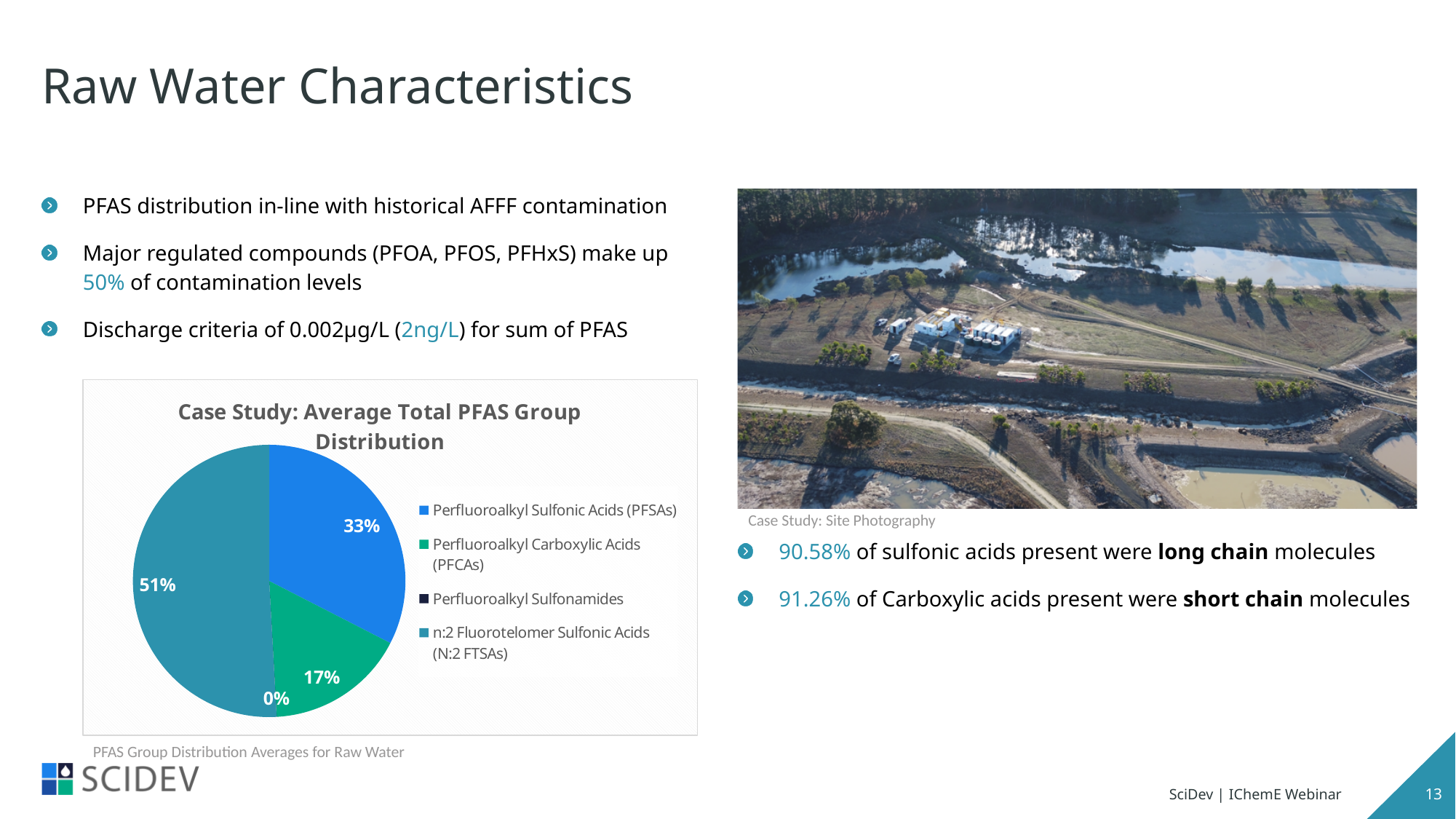
What kind of chart is shown on the slide? Pie chart What share of the pie is n:2 Fluorotelomer Sulfonic Acids (N:2 FTSAs)? 51% Which is larger, the share for PFSAs or the share for PFCAs? Perfluoroalkyl Sulfonic Acids (PFSAs) Which PFAS group has the largest share of the pie? n:2 Fluorotelomer Sulfonic Acids (N:2 FTSAs) What is the difference in percentage points between the PFSAs share and the PFCAs share? 16 How many PFAS groups are listed in the chart legend? 4 Which PFAS group has the smallest share of the pie? Perfluoroalkyl Sulfonamides What share of the pie is Perfluoroalkyl Sulfonic Acids (PFSAs)? 33% What share of the pie is Perfluoroalkyl Carboxylic Acids (PFCAs)? 17% What is the title of the chart? Case Study: Average Total PFAS Group Distribution What colour is the slice for n:2 Fluorotelomer Sulfonic Acids (N:2 FTSAs)? Teal